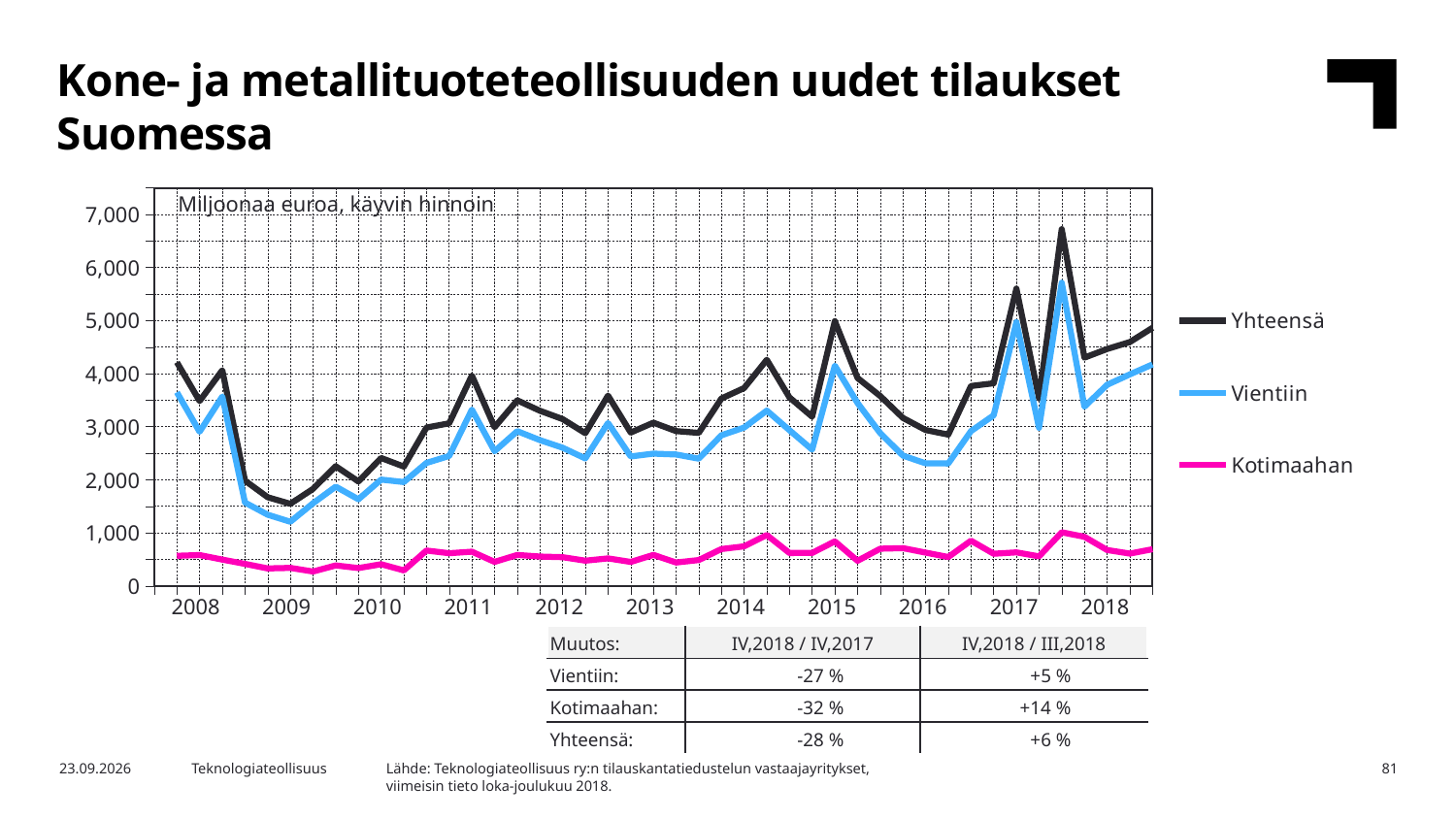
Which series in the chart has the lowest values throughout the whole period? Kotimaahan Does the Yhteensä series rise or fall between 2008 and 2009? fall Is the lowest value of the Yhteensä series, reached around 2009, greater or less than 2,000? less How many year labels are shown on the x axis? 11 How many series does the chart legend list? 3 Is the value of the Kotimaahan series at the start of 2008 greater or less than 1,000? less Which series in the chart has the highest values throughout the whole period? Yhteensä What unit is stated in the chart's label at the top of the plot area? Miljoonaa euroa, käyvin hinnoin In 2015, which series has the larger value: Yhteensä or Kotimaahan? Yhteensä Is the peak value of the Yhteensä series in 2017 greater or less than 6,000? greater What kind of chart is shown on the slide? line chart